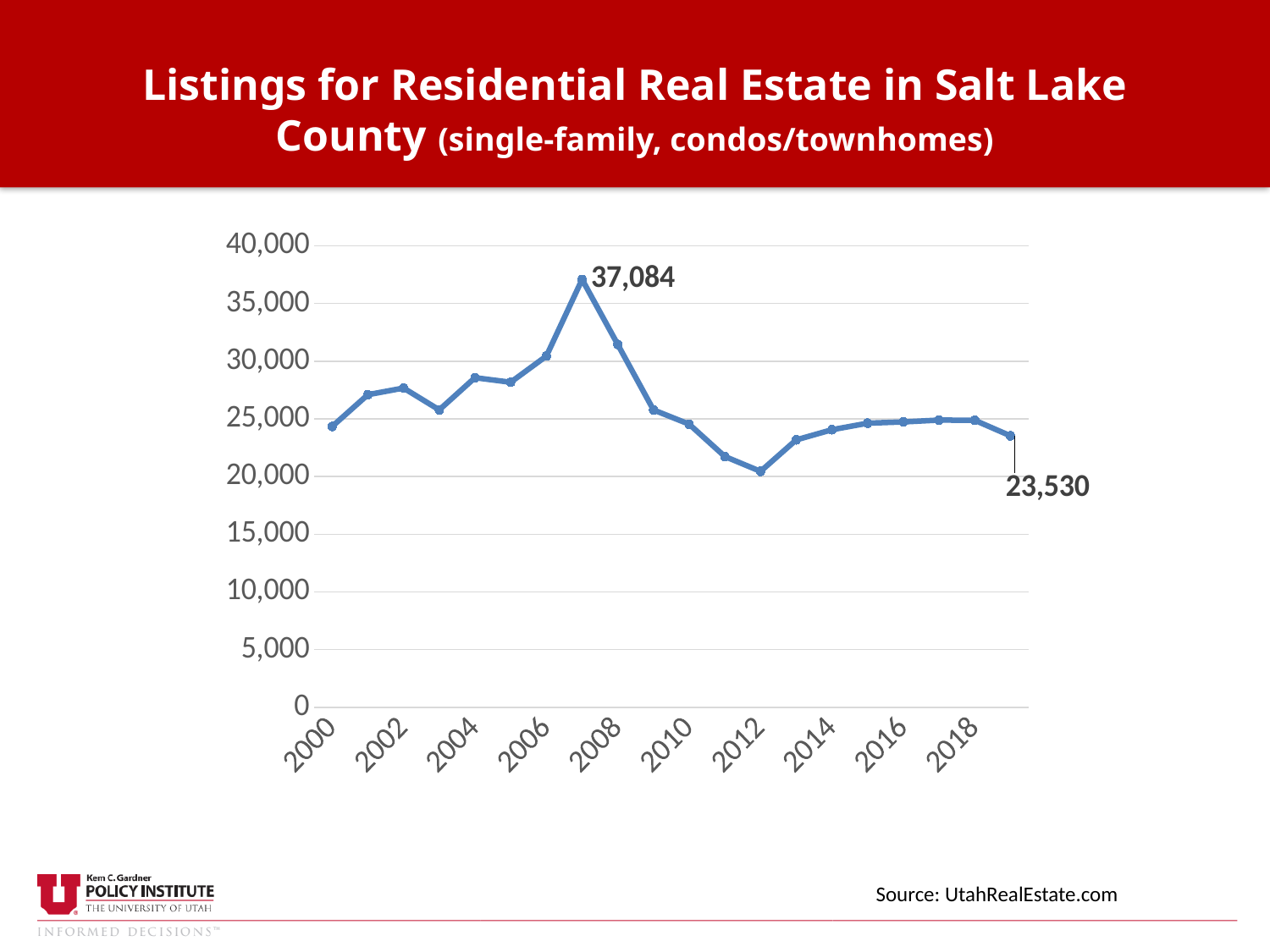
Do listings rise or fall between 2007 and 2012? Fall What type of chart is shown on the slide? Line chart What is the value labeled at the final data point of the line? 23,530 What is the difference between the labeled peak value (37,084) and the labeled final value (23,530)? 13,554 How many yearly data points are plotted on the line? 20 Is the value for 2008 greater or less than 30,000? greater What source is cited for the chart data? UtahRealEstate.com Is the value for 2004 greater or less than 25,000? greater What is the peak value of listings labeled on the chart? 37,084 In which year do listings reach their highest value? 2007 Is the value for 2012 greater or less than 25,000? less In which year do listings reach their lowest value? 2012